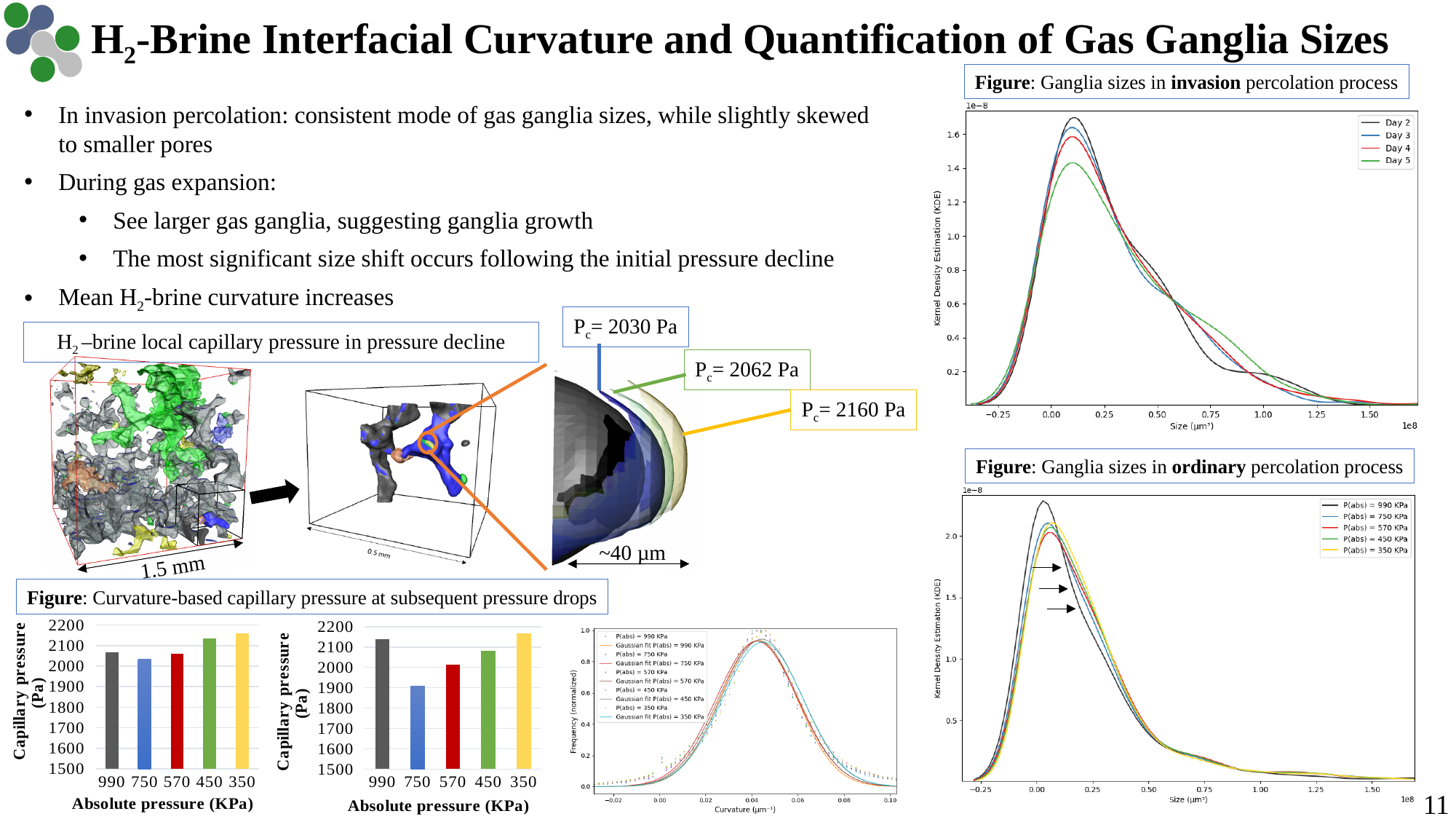
In the left bar chart of capillary pressure, is the value for 750 KPa greater or less than 2100? less In the chart 'Ganglia sizes in ordinary percolation process', which series has the highest peak? P(abs) = 990 KPa In the right bar chart of capillary pressure (second bar chart from the left), which absolute pressure has the lowest capillary pressure? 750 In the chart 'Ganglia sizes in invasion percolation process', how many series does the legend list? 4 In the left bar chart of capillary pressure, is the value for 350 KPa greater or less than 2100? greater In the left bar chart of capillary pressure, how many absolute pressure categories are plotted? 5 In the chart 'Ganglia sizes in invasion percolation process', which series has the highest peak? Day 2 In the left bar chart under 'Curvature-based capillary pressure at subsequent pressure drops', what kind of chart is shown? bar chart In the right bar chart of capillary pressure (second bar chart from the left), which is larger, the value for 990 KPa or the value for 750 KPa? 990 KPa In the left bar chart of capillary pressure, which absolute pressure has the highest capillary pressure? 350 In the right bar chart of capillary pressure (second bar chart from the left), is the value for 750 KPa greater or less than 2000? less In the chart 'Ganglia sizes in ordinary percolation process', how many series does the legend list? 5